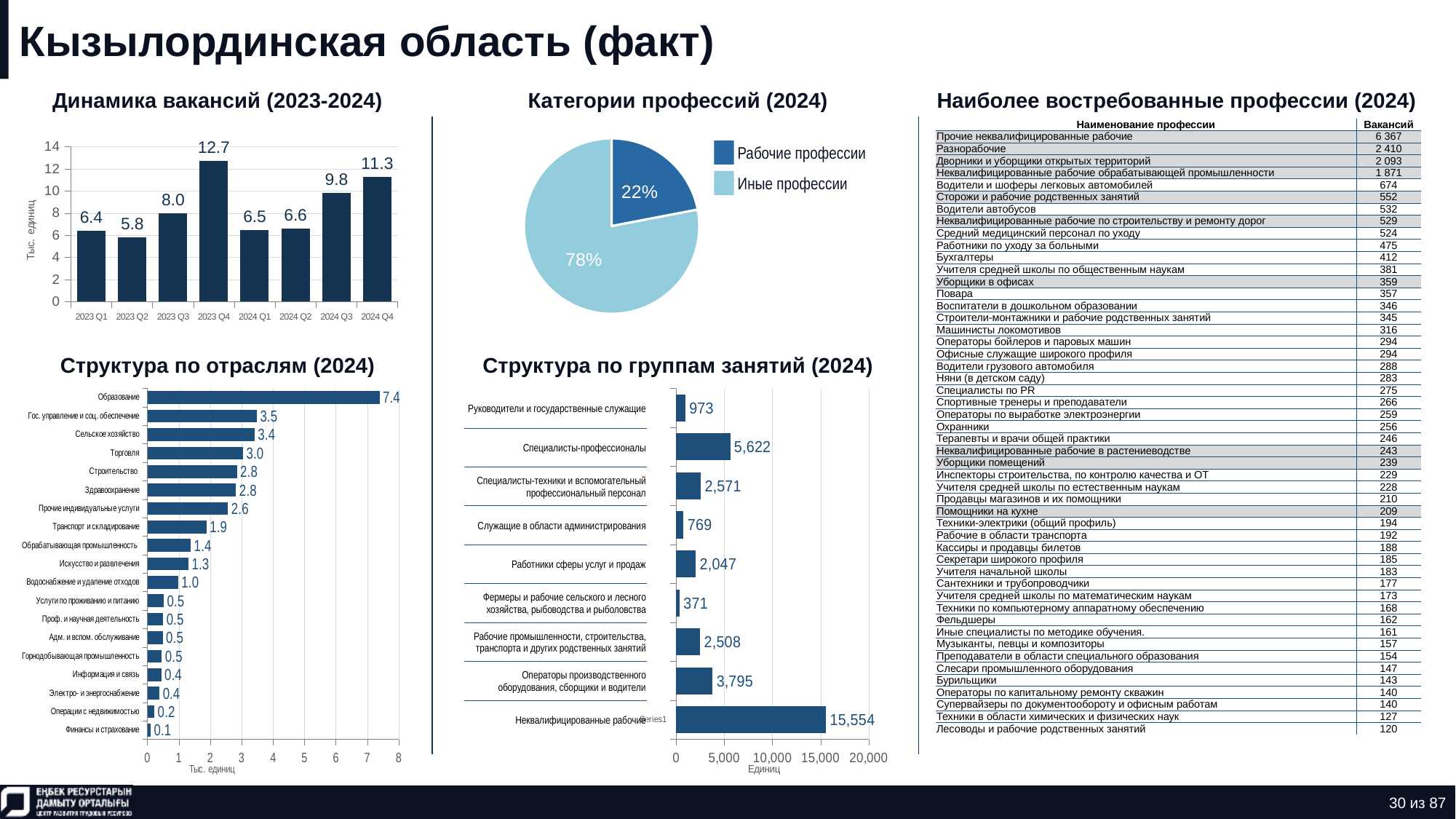
In the chart 'Структура по отраслям (2024)', what is the value for 'Образование'? 7.4 In the chart 'Динамика вакансий (2023-2024)', what is the difference between 2024 Q4 and 2024 Q3? 1.5 In the chart 'Динамика вакансий (2023-2024)', what is the value for 2023 Q4? 12.7 In the chart 'Структура по отраслям (2024)', which category has the lowest value? Финансы и страхование In the chart 'Динамика вакансий (2023-2024)', how many quarters are plotted? 8 In the chart 'Структура по группам занятий (2024)', what is the difference between 'Операторы производственного оборудования, сборщики и водители' and 'Рабочие промышленности, строительства, транспорта и других родственных занятий'? 1,287 In the chart 'Динамика вакансий (2023-2024)', which quarter has the lowest value? 2023 Q2 What type of chart is 'Категории профессий (2024)'? pie chart In the chart 'Структура по отраслям (2024)', which is larger: 'Торговля' or 'Строительство'? Торговля In the pie chart 'Категории профессий (2024)', what share does 'Рабочие профессии' have? 22% In the chart 'Структура по группам занятий (2024)', what is the value for 'Специалисты-профессионалы'? 5,622 In the chart 'Структура по группам занятий (2024)', which category has the highest value? Неквалифицированные рабочие